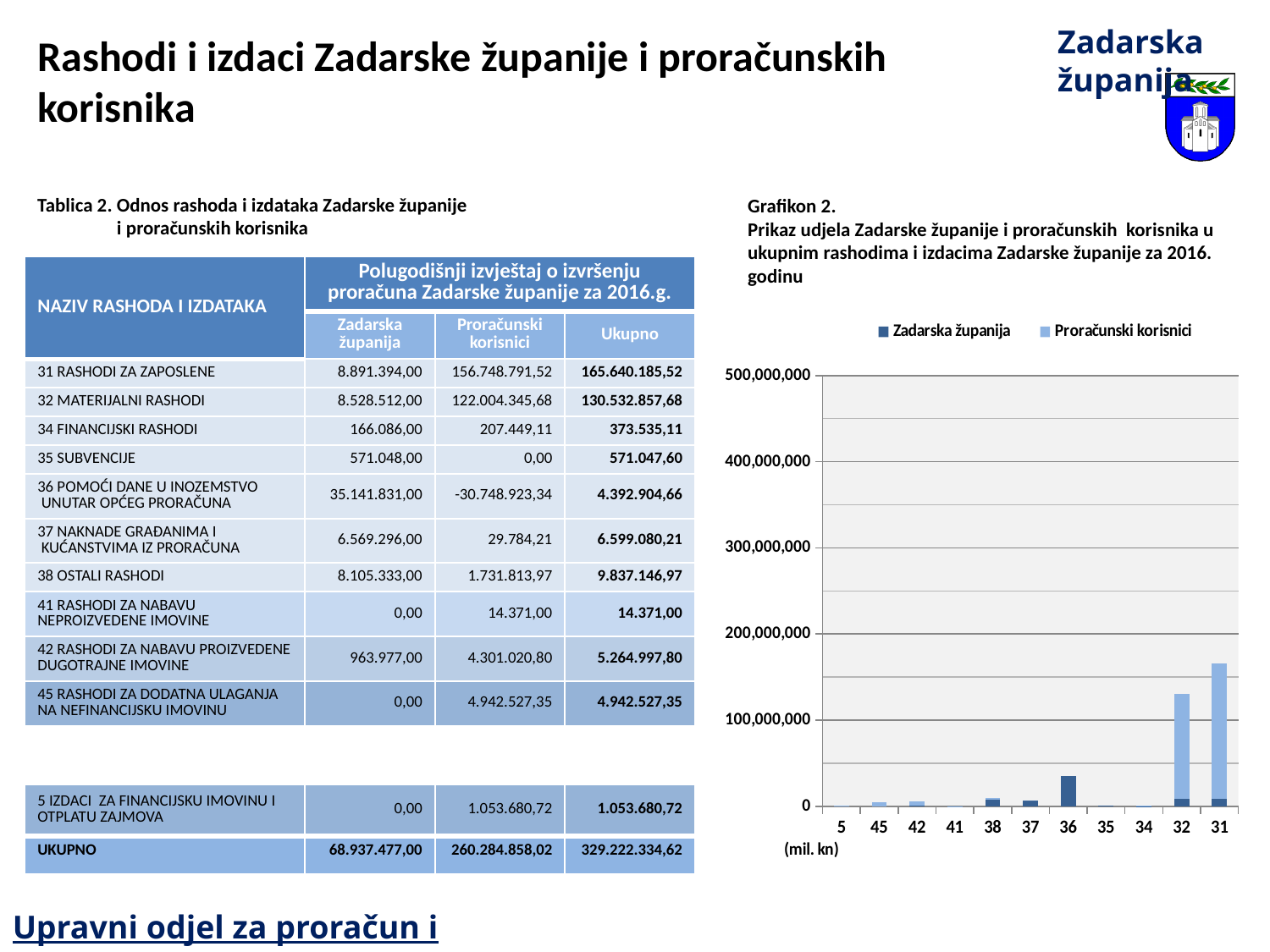
In Grafikon 2, is the Proračunski korisnici value for category 32 greater or less than 100,000,000? greater In Grafikon 2, which is larger for Zadarska županija: category 36 or category 31? 36 In Grafikon 2, is the Proračunski korisnici value for category 31 greater or less than 100,000,000? greater What kind of chart is Grafikon 2? bar chart In Grafikon 2, which category has the highest Zadarska županija bar? 36 In Grafikon 2, is the Zadarska županija value for category 36 greater or less than 100,000,000? less How many series does the legend of Grafikon 2 list? 2 How many categories are shown on the x axis of Grafikon 2? 11 In Grafikon 2, which category has the highest Proračunski korisnici bar? 31 In Grafikon 2, which series is shown in dark blue? Zadarska županija In Grafikon 2, which is larger for Proračunski korisnici: category 31 or category 32? 31